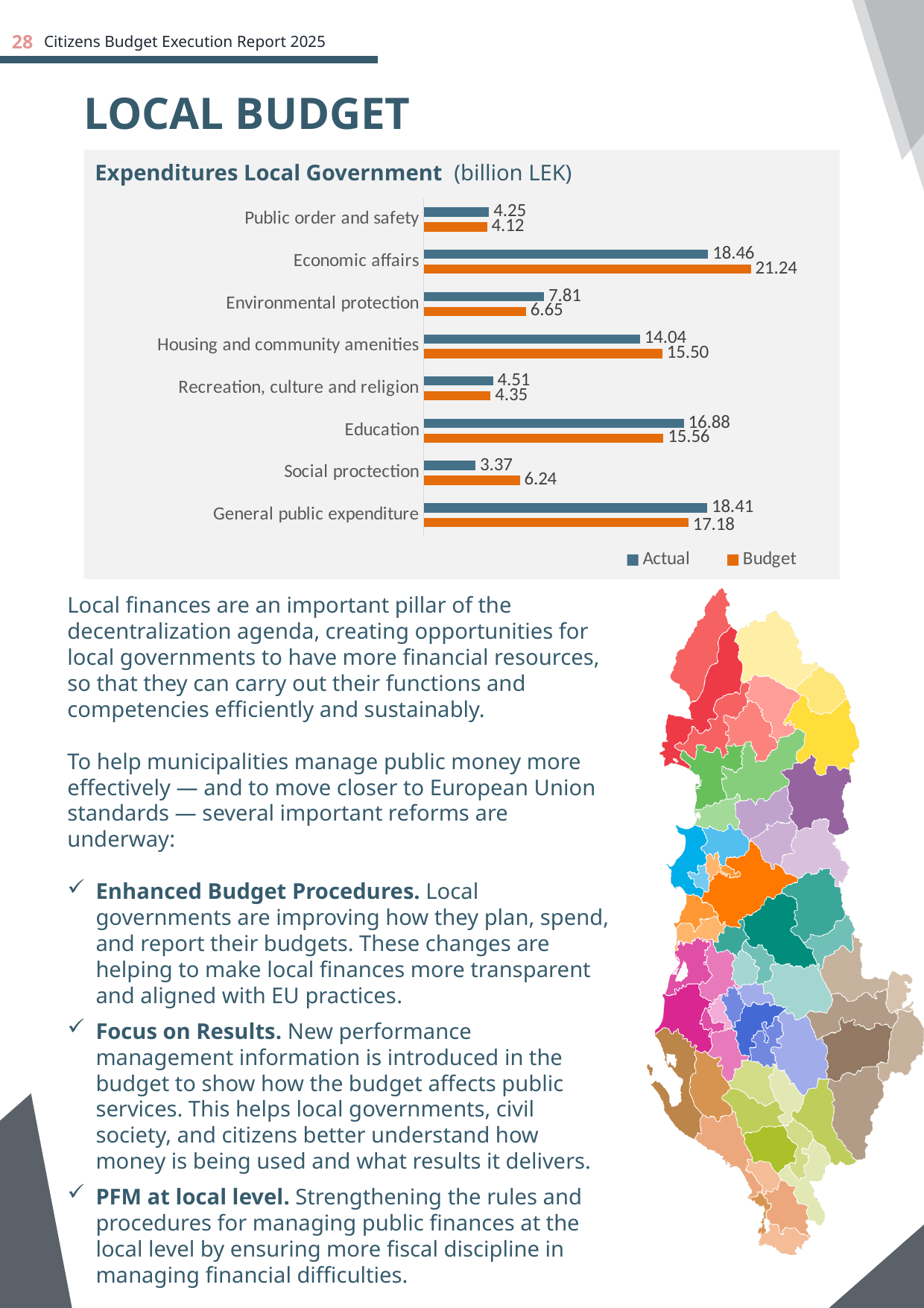
What is the title of the chart? Expenditures Local Government (billion LEK) Which category has the lowest Actual value? Social proctection What is the Budget value for Housing and community amenities? 15.50 What is the difference between the Budget and Actual values for Economic affairs? 2.78 Which colour represents the Budget series in the chart? Orange Which is larger for Education, the Actual value or the Budget value? Actual What is the Budget value for Social proctection? 6.24 Which category has the highest Budget value? Economic affairs How many series does the legend list? 2 What kind of chart is shown on the slide? Bar chart How many categories are shown in the chart? 8 What is the Actual value for Economic affairs? 18.46